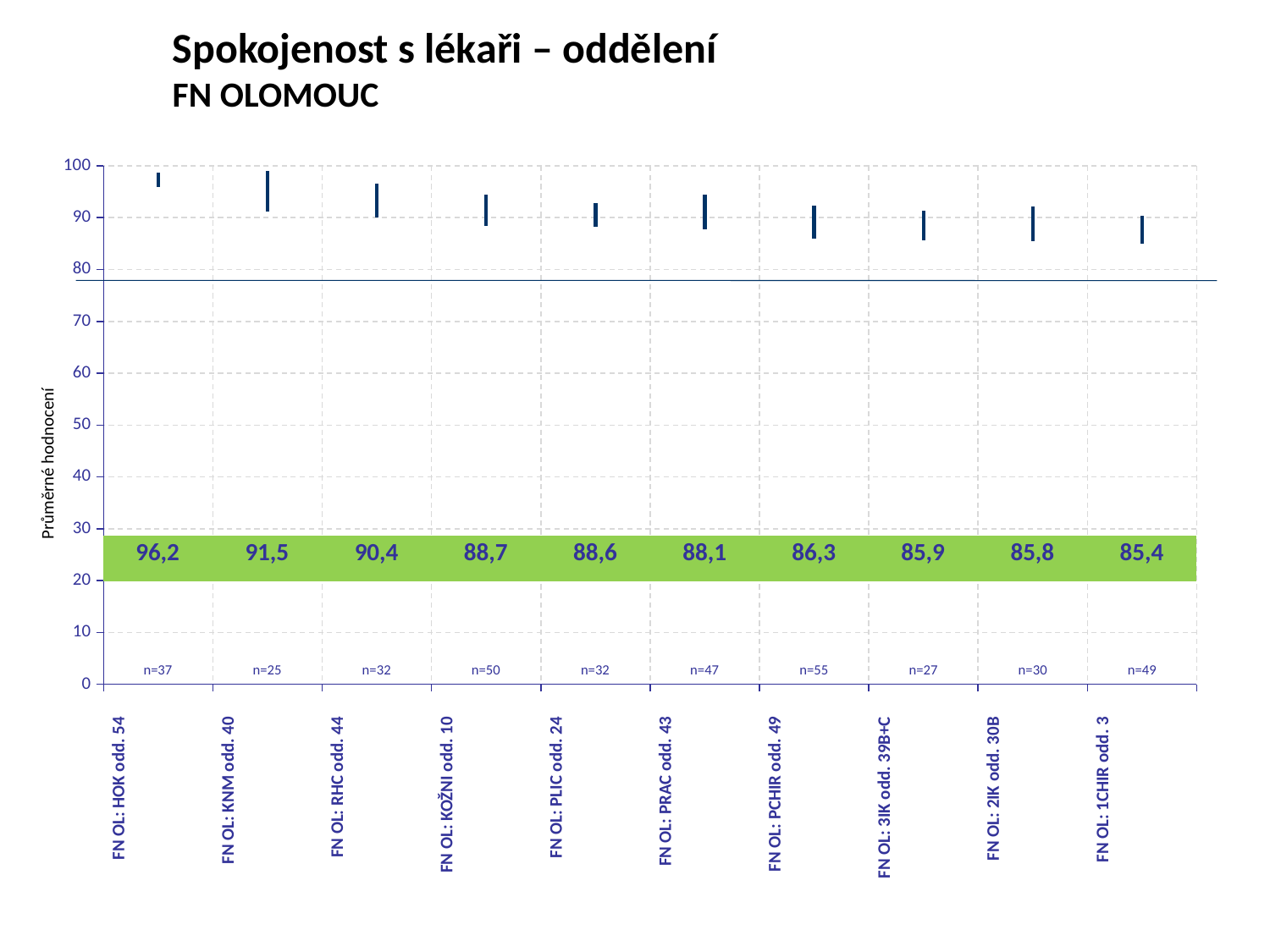
What is the number of respondents (n) for FN OL: PRAC odd. 43? n=47 What is the average rating for FN OL: KOŽNI odd. 10? 88,7 What is the label of the vertical axis? Průměrné hodnocení Which department has the lowest average rating? FN OL: 1CHIR odd. 3 Which has a higher average rating, FN OL: KNM odd. 40 or FN OL: RHC odd. 44? FN OL: KNM odd. 40 Which department has the largest number of respondents (n)? FN OL: PCHIR odd. 49 What is the average rating for FN OL: HOK odd. 54? 96,2 What is the difference between the average ratings of FN OL: HOK odd. 54 and FN OL: 1CHIR odd. 3? 10,8 Do the average ratings rise or fall from left to right along the x axis? fall How many departments are shown on the chart? 10 What is the average rating for FN OL: PCHIR odd. 49? 86,3 Which department has the highest average rating? FN OL: HOK odd. 54